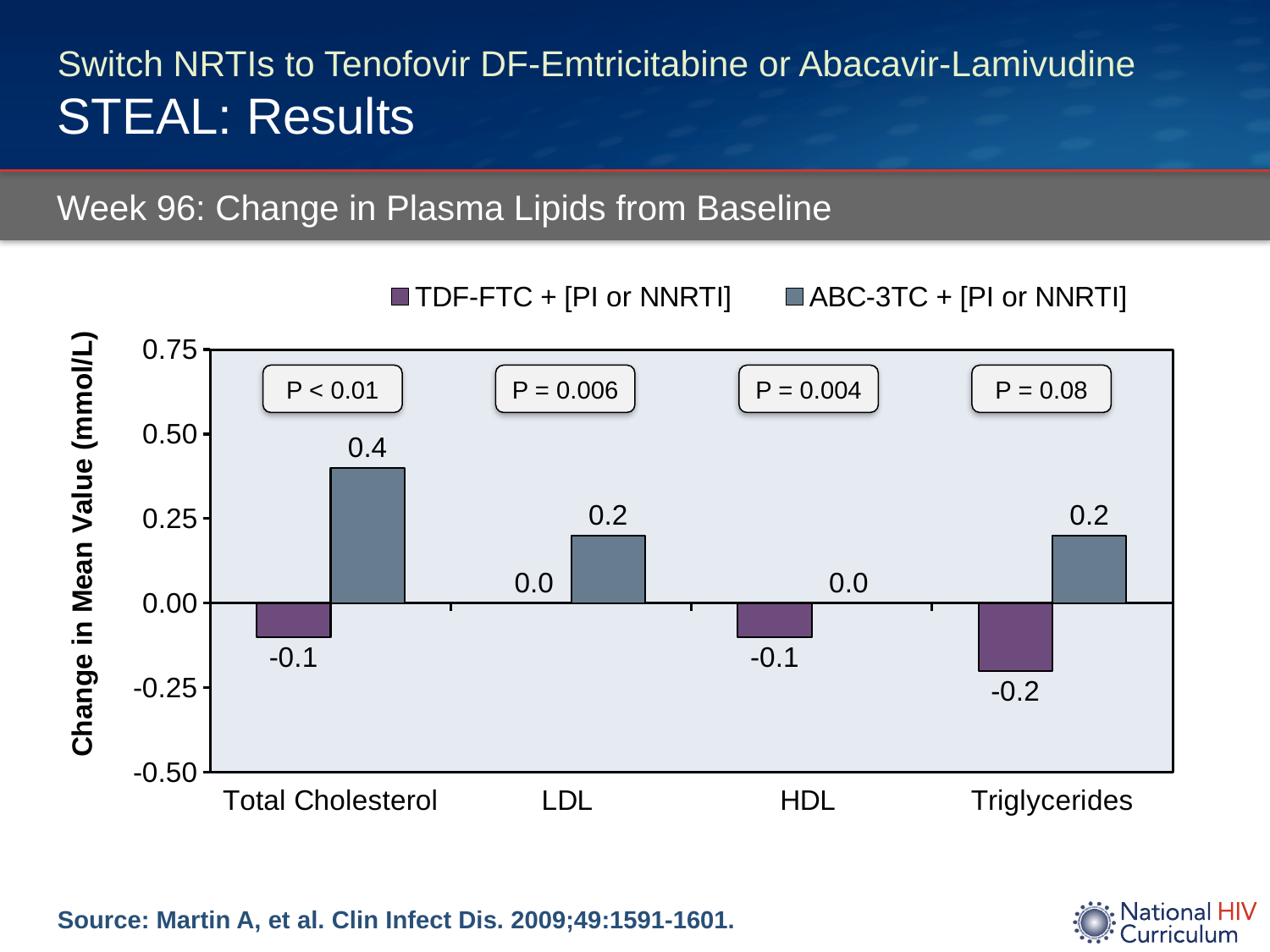
How many series does the legend list? 2 What is the change in mean value for HDL in the TDF-FTC + [PI or NNRTI] series? -0.1 How many lipid categories are shown on the x axis? 4 What is the change in mean value for Total Cholesterol in the ABC-3TC + [PI or NNRTI] series? 0.4 For Triglycerides, which series has the larger value, TDF-FTC + [PI or NNRTI] or ABC-3TC + [PI or NNRTI]? ABC-3TC + [PI or NNRTI] What is the difference between the ABC-3TC + [PI or NNRTI] and TDF-FTC + [PI or NNRTI] values for Total Cholesterol? 0.5 What is the change in mean value for LDL in the ABC-3TC + [PI or NNRTI] series? 0.2 Which category has the lowest value in the TDF-FTC + [PI or NNRTI] series? Triglycerides What kind of chart is shown on the slide? Bar chart What P value is shown above the HDL bars? P = 0.004 Which category has the highest value in the ABC-3TC + [PI or NNRTI] series? Total Cholesterol What is the change in mean value for Triglycerides in the TDF-FTC + [PI or NNRTI] series? -0.2